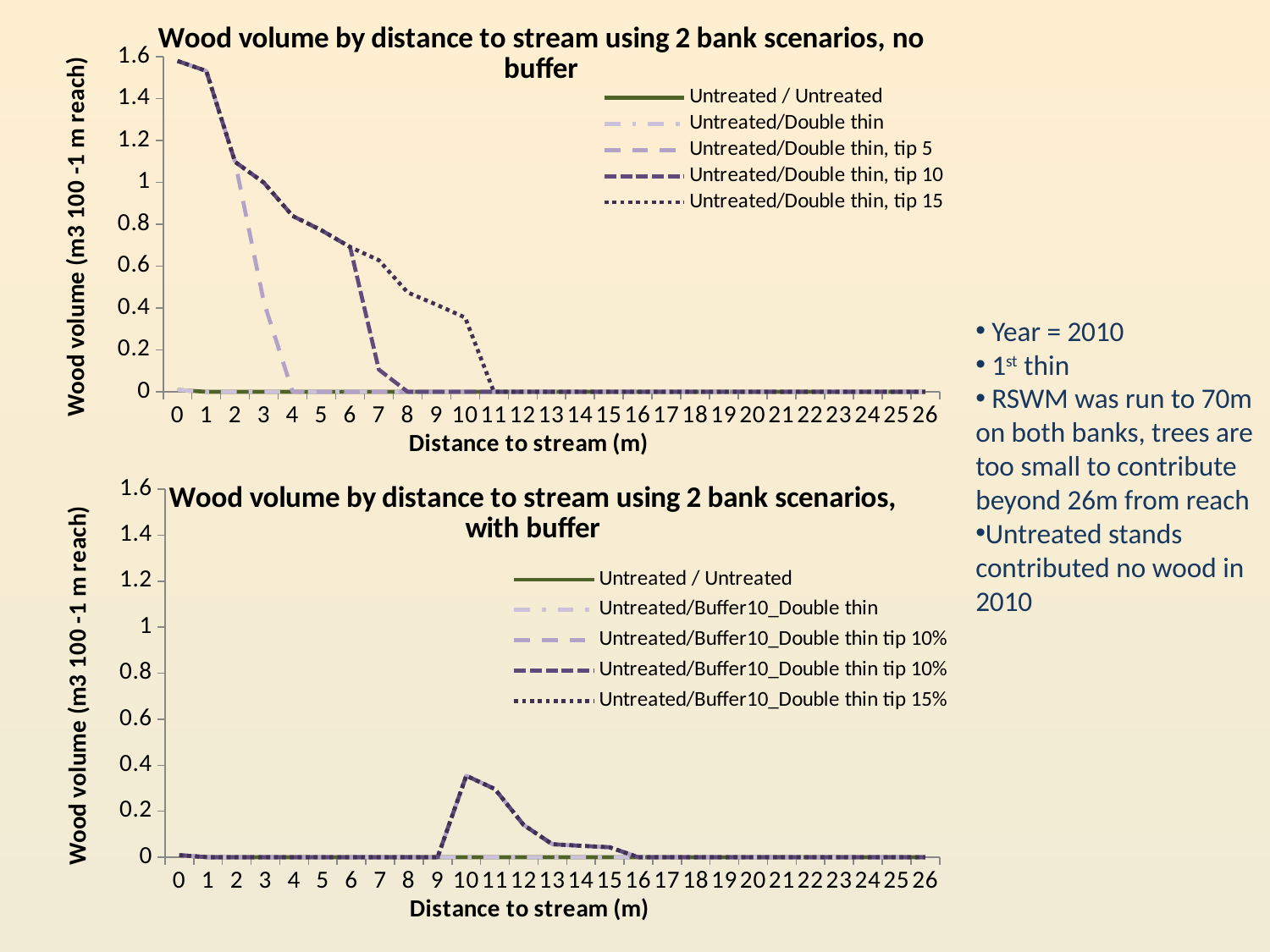
In the bottom chart (with buffer), is the value of the dashed 'Untreated/Buffer10_Double thin tip 10%' series at distance 13 greater or less than 0.2? less What is the x-axis title of the bottom chart (with buffer)? Distance to stream (m) In the top chart (no buffer), how many distance values are shown along the x axis? 27 In the top chart (no buffer), is the value of 'Untreated/Double thin, tip 15' at distance 0 greater or less than 1.4? greater In the top chart (no buffer), is the value of 'Untreated/Double thin, tip 15' at distance 10 greater or less than 0.2? greater What kind of chart is the top chart, 'Wood volume by distance to stream using 2 bank scenarios, no buffer'? line chart How many series does the legend of the bottom chart (with buffer) list? 5 In the top chart (no buffer), at distance 4, which series has the larger value: 'Untreated/Double thin, tip 5' or 'Untreated/Double thin, tip 10'? Untreated/Double thin, tip 10 How many series does the legend of the top chart (no buffer) list? 5 In the top chart (no buffer), does the 'Untreated/Double thin, tip 15' series rise or fall as distance to stream increases? fall